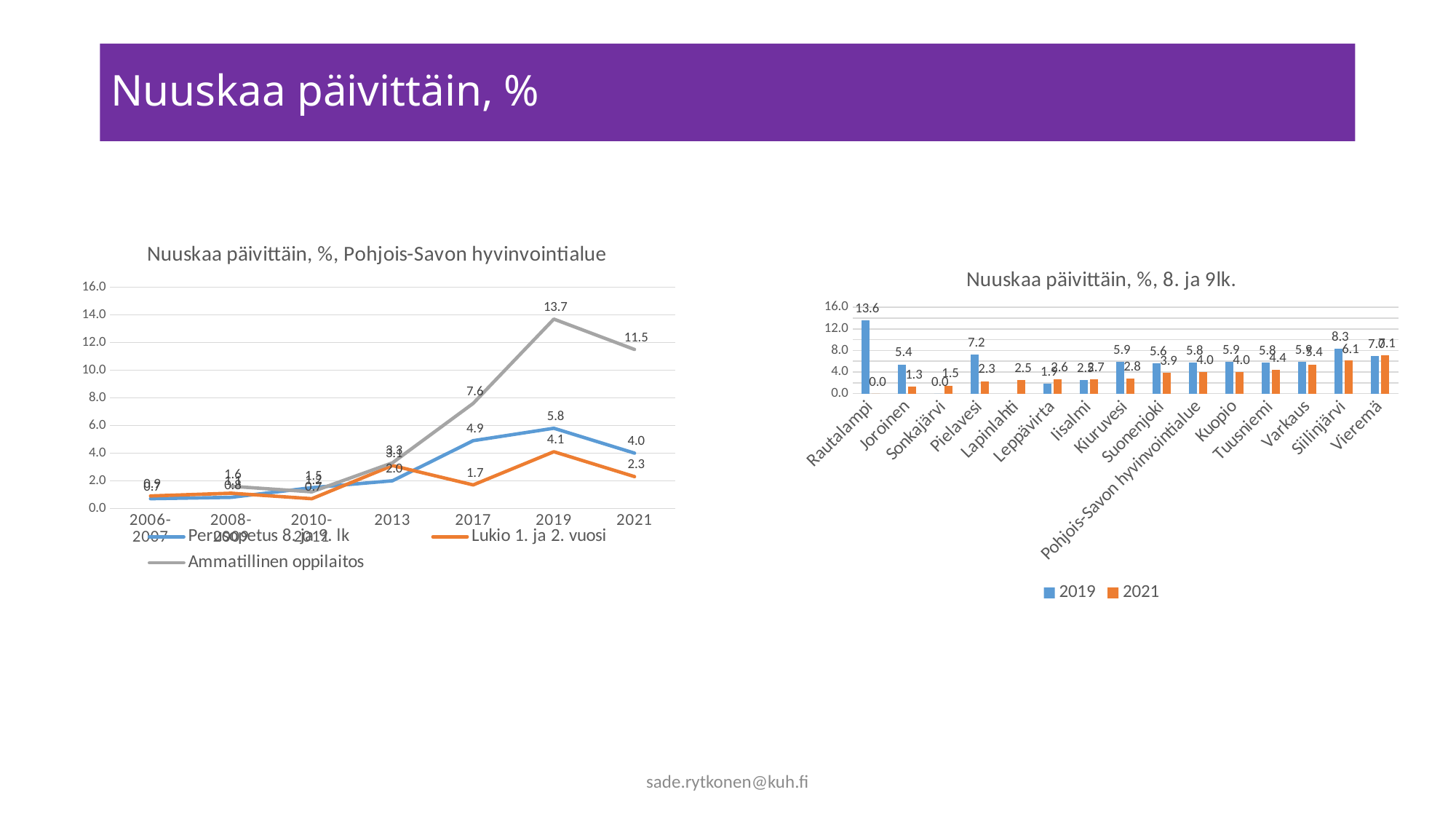
In the left chart (Nuuskaa päivittäin, %, Pohjois-Savon hyvinvointialue), what is the value for Perusopetus 8. ja 9. lk in 2017? 4.9 What kind of chart is the left chart (Nuuskaa päivittäin, %, Pohjois-Savon hyvinvointialue)? Line chart In the left chart (Nuuskaa päivittäin, %, Pohjois-Savon hyvinvointialue), in which year does Ammatillinen oppilaitos reach its highest value? 2019 In the left chart (Nuuskaa päivittäin, %, Pohjois-Savon hyvinvointialue), what is the value for Ammatillinen oppilaitos in 2019? 13.7 In the right chart (Nuuskaa päivittäin, %, 8. ja 9lk.), what is the 2021 value for Siilinjärvi? 6.1 In the left chart (Nuuskaa päivittäin, %, Pohjois-Savon hyvinvointialue), what is the value for Lukio 1. ja 2. vuosi in 2021? 2.3 How many series does the legend of the left chart (Nuuskaa päivittäin, %, Pohjois-Savon hyvinvointialue) list? 3 In the right chart (Nuuskaa päivittäin, %, 8. ja 9lk.), which is larger, the 2019 value for Siilinjärvi or the 2019 value for Kuopio? Siilinjärvi In the right chart (Nuuskaa päivittäin, %, 8. ja 9lk.), what is the 2019 value for Rautalampi? 13.6 In the right chart (Nuuskaa päivittäin, %, 8. ja 9lk.), which municipality has the highest 2019 value? Rautalampi In the right chart (Nuuskaa päivittäin, %, 8. ja 9lk.), what is the difference between the 2019 and 2021 values for Pielavesi? 4.9 In the left chart (Nuuskaa päivittäin, %, Pohjois-Savon hyvinvointialue), by how much did the Ammatillinen oppilaitos value fall from 2019 to 2021? 2.2